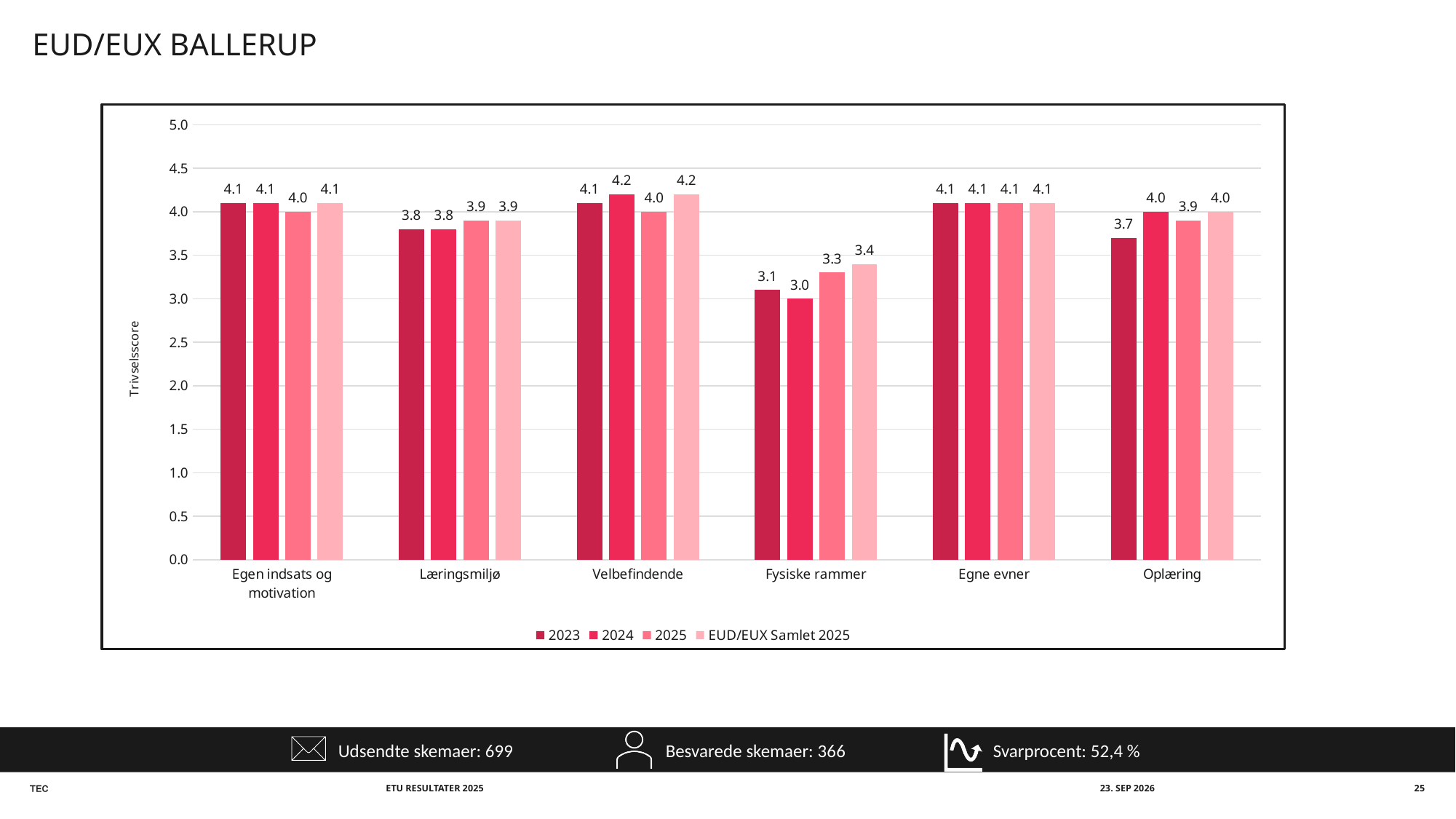
What kind of chart is shown on the slide? Bar chart Which category has the highest 2024 value? Velbefindende What is the 2023 value for Oplæring? 3.7 Which is larger for Fysiske rammer: the 2023 value or the 2025 value? 2025 What is the difference between the 2024 and 2023 values for Oplæring? 0.3 How many categories are shown on the x axis? 6 What is the 2024 value for Læringsmiljø? 3.8 How many series does the legend list? 4 What is the EUD/EUX Samlet 2025 value for Velbefindende? 4.2 What is the 2025 value for Fysiske rammer? 3.3 What is the label of the y axis? Trivselsscore Which category has the lowest 2024 value? Fysiske rammer